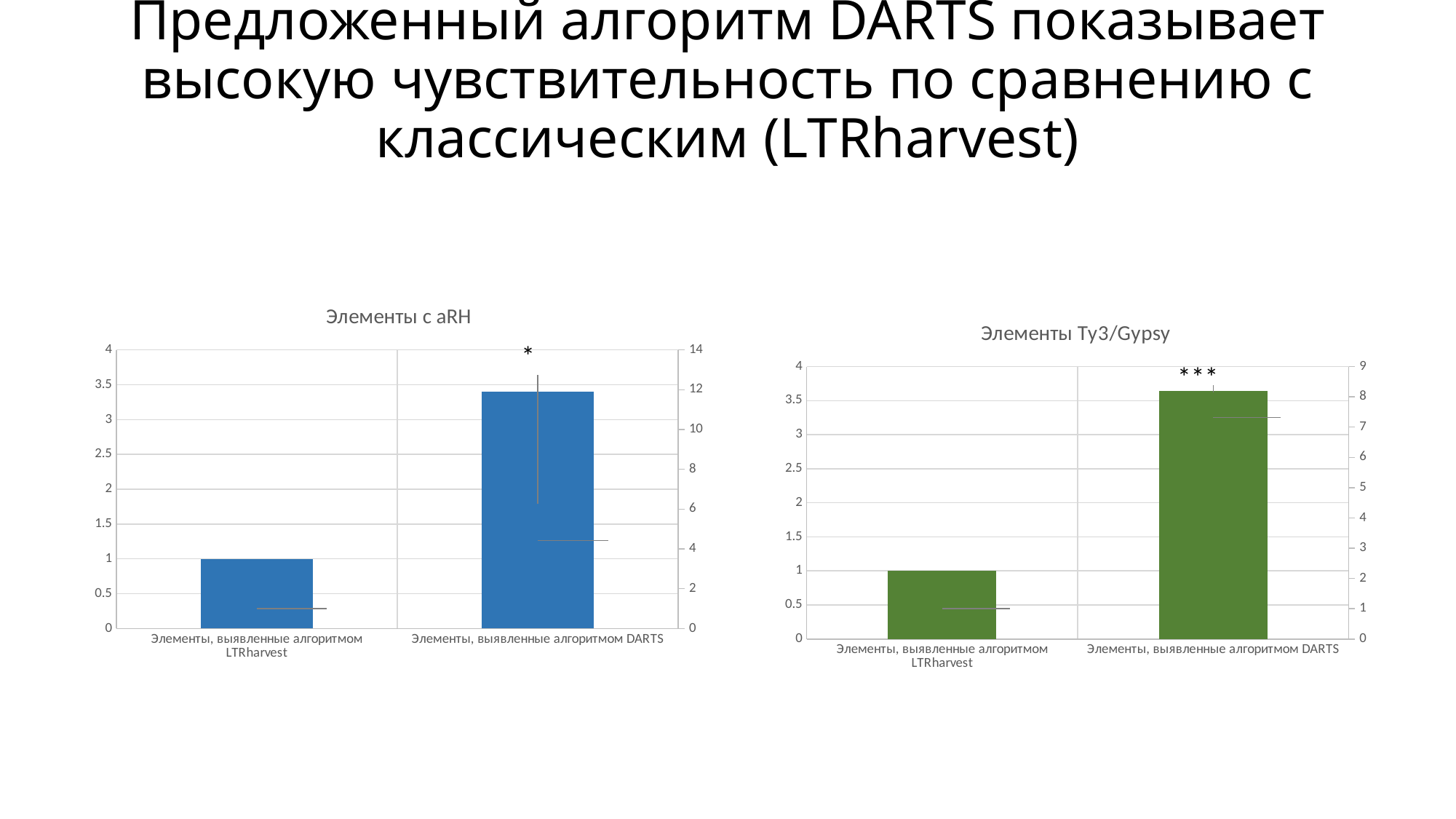
In the "Элементы с aRH" chart, is the value for "Элементы, выявленные алгоритмом DARTS" greater or less than 3.5 on the left axis? less In the "Элементы Ty3/Gypsy" chart, what is the value for "Элементы, выявленные алгоритмом LTRharvest" on the left axis? 1 In the "Элементы с aRH" chart, which category has the highest bar? Элементы, выявленные алгоритмом DARTS What is the title of the chart on the right side of the slide? Элементы Ty3/Gypsy What kind of chart is the "Элементы с aRH" chart? bar chart How many bars does the "Элементы Ty3/Gypsy" chart show? 2 In the "Элементы Ty3/Gypsy" chart, which category has the lowest bar? Элементы, выявленные алгоритмом LTRharvest In the "Элементы Ty3/Gypsy" chart, is the value for "Элементы, выявленные алгоритмом DARTS" greater or less than 3.5 on the left axis? greater What colour are the bars in the "Элементы Ty3/Gypsy" chart? green In the "Элементы с aRH" chart, what is the value for "Элементы, выявленные алгоритмом LTRharvest" on the left axis? 1 In the "Элементы Ty3/Gypsy" chart, which is larger: the bar for LTRharvest or the bar for DARTS? DARTS In the "Элементы с aRH" chart, is the value for "Элементы, выявленные алгоритмом DARTS" greater or less than 3 on the left axis? greater